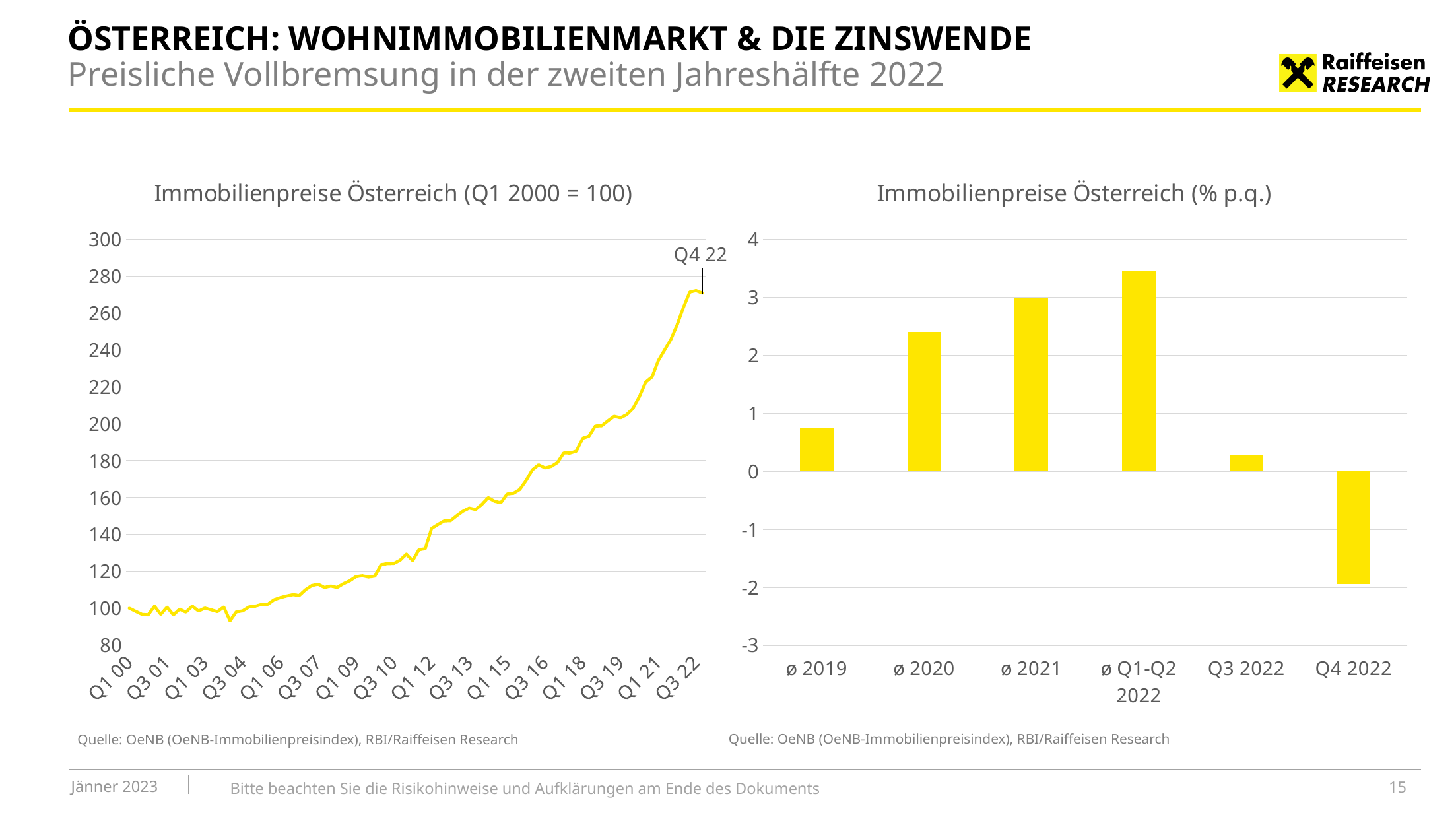
In the right chart 'Immobilienpreise Österreich (% p.q.)', is the value for ø 2019 greater or less than 1? less In the right chart 'Immobilienpreise Österreich (% p.q.)', which category has the lowest value? Q4 2022 In the right chart 'Immobilienpreise Österreich (% p.q.)', which is larger, the value for ø 2021 or the value for Q3 2022? ø 2021 What is the title of the right chart on the slide? Immobilienpreise Österreich (% p.q.) What kind of chart is the left chart, 'Immobilienpreise Österreich (Q1 2000 = 100)'? line chart In the left chart 'Immobilienpreise Österreich (Q1 2000 = 100)', do the values generally rise or fall from Q1 00 to Q3 22? rise In the right chart 'Immobilienpreise Österreich (% p.q.)', is the value for ø 2020 greater or less than 2? greater In the right chart 'Immobilienpreise Österreich (% p.q.)', how many categories are shown on the x axis? 6 In the right chart 'Immobilienpreise Österreich (% p.q.)', is the value for Q4 2022 greater or less than -1? less In the right chart 'Immobilienpreise Österreich (% p.q.)', which category has the highest value? ø Q1-Q2 2022 What kind of chart is the right chart, 'Immobilienpreise Österreich (% p.q.)'? bar chart